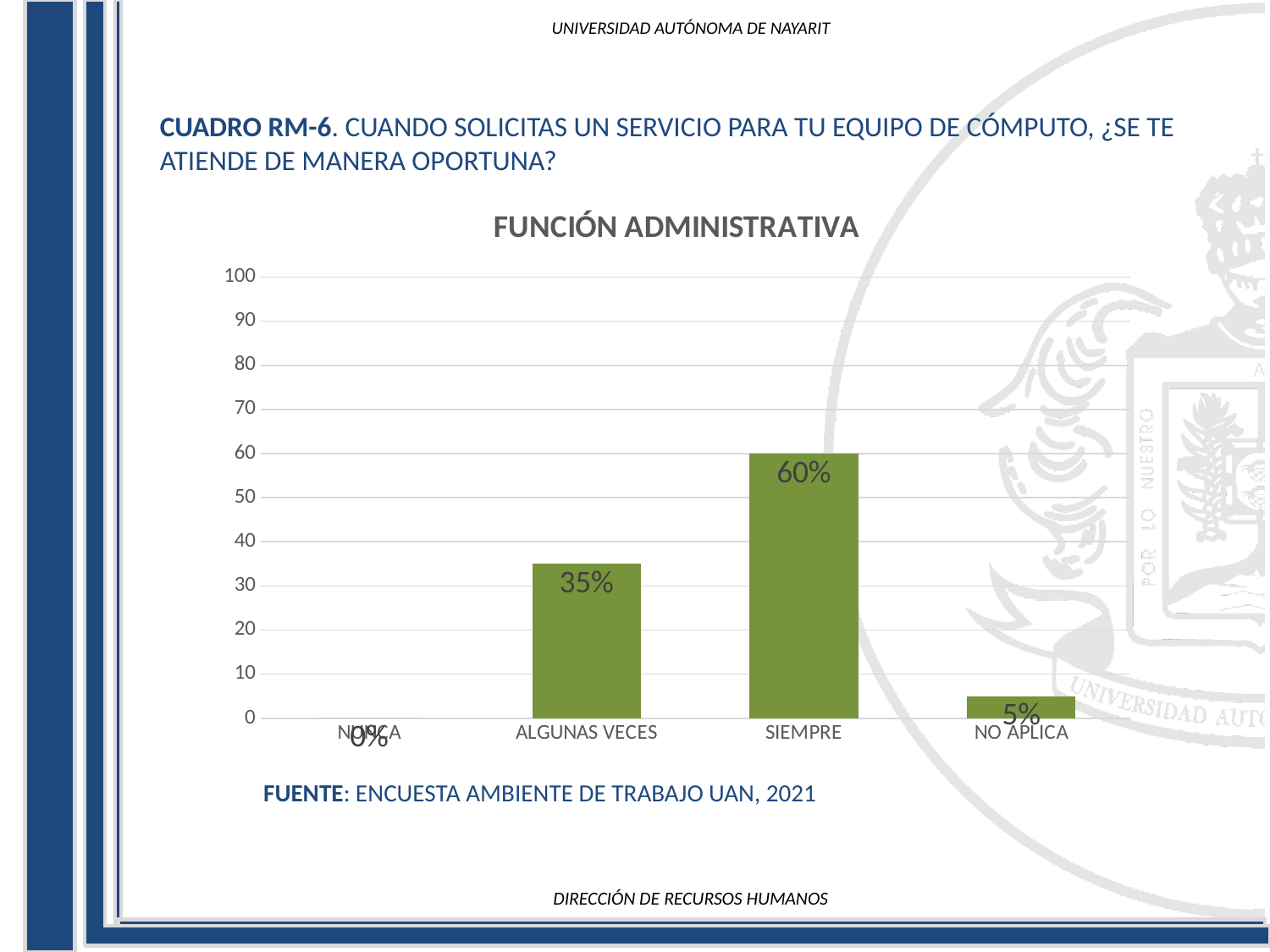
Is the value for SIEMPRE greater or less than 50? greater What is the title of the chart? FUNCIÓN ADMINISTRATIVA How many categories are shown on the x axis? 4 What is the value for ALGUNAS VECES? 35% What is the value for SIEMPRE? 60% Which is larger, the value for ALGUNAS VECES or the value for NO APLICA? ALGUNAS VECES What is the value for NUNCA? 0% Which category has the lowest value? NUNCA What kind of chart is shown? bar chart What is the value for NO APLICA? 5% Which category has the highest value? SIEMPRE What is the difference between the values for SIEMPRE and ALGUNAS VECES? 25%